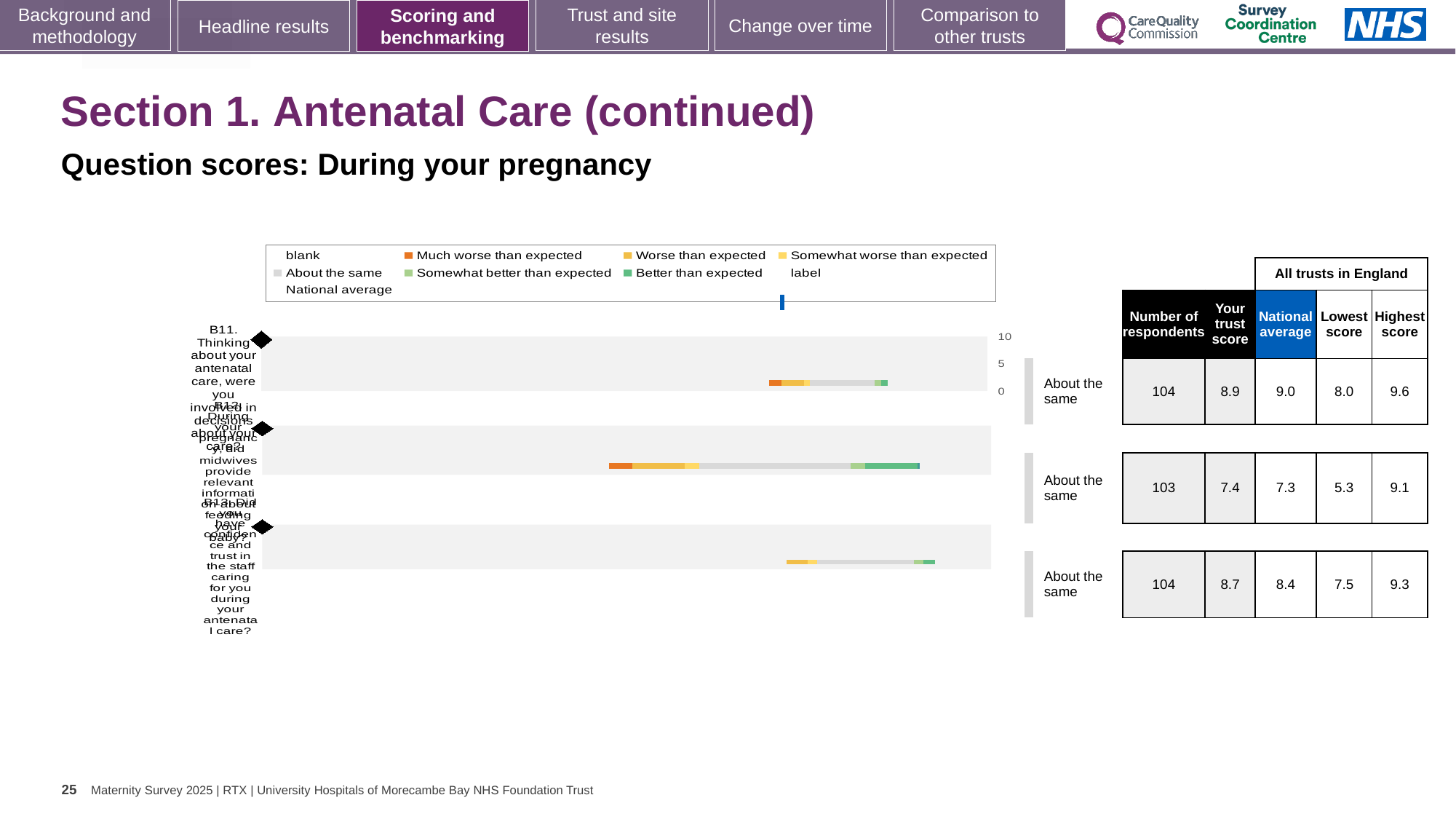
What is the national average shown for question B12? 7.3 What is the difference between the highest score and the lowest score for question B11? 1.6 How many respondents are shown for question B12? 103 For question B13, which is larger: the trust score or the national average? the trust score What is the highest score across all trusts in England for question B13? 9.3 What benchmark category is shown for each of the three questions? About the same What does the blue vertical marker in the chart represent, according to the legend? National average What kind of chart is used to show the question scores on this slide? bar chart What is the trust score shown for question B11? 8.9 How many questions (categories) are plotted in the chart? 3 Which question has the highest trust score? B11 Which question has the lowest 'Lowest score' across all trusts in England? B12